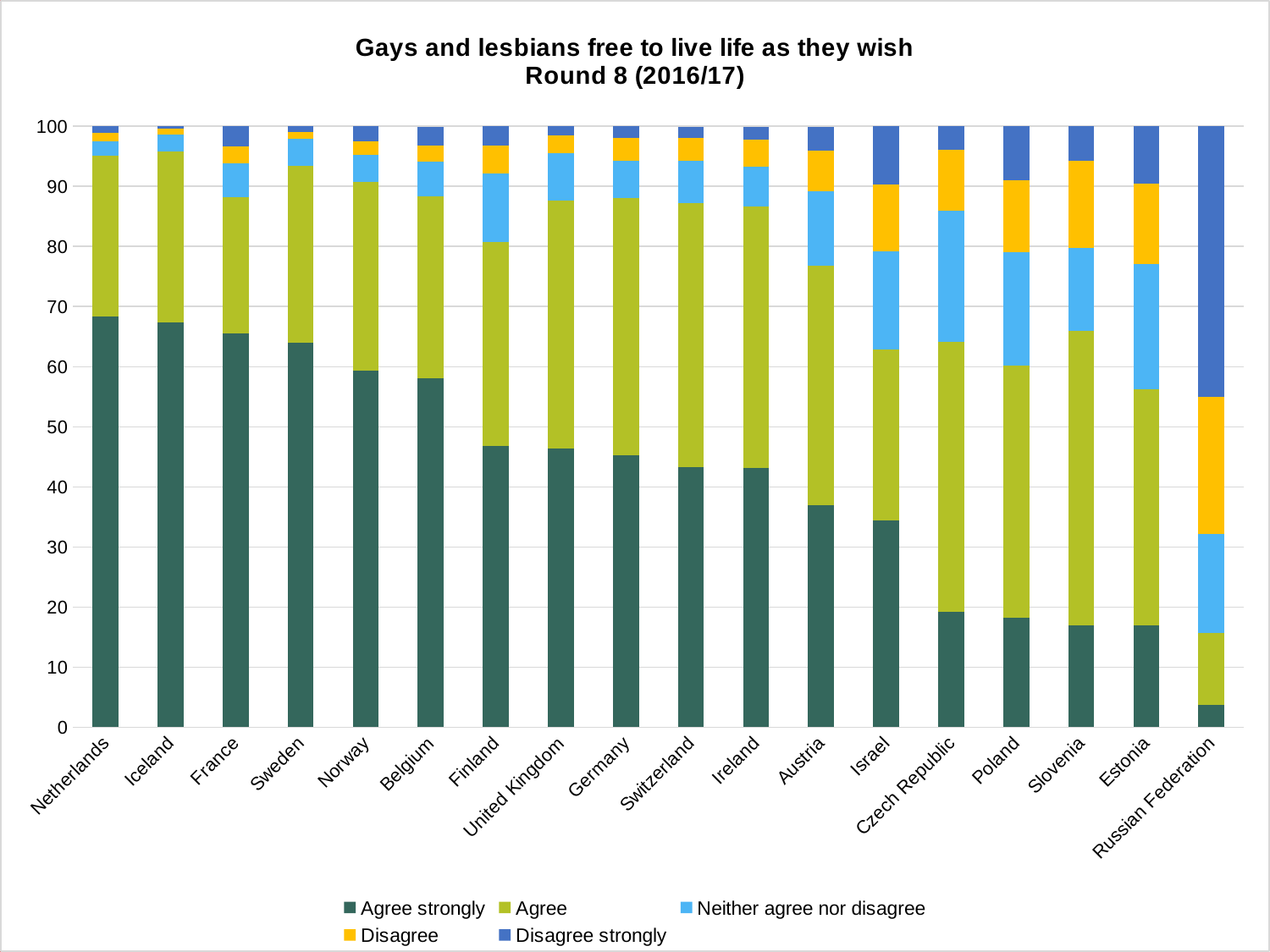
Do the 'Agree strongly' values rise or fall moving from left to right along the x axis? fall What is the title of the chart? Gays and lesbians free to live life as they wish Round 8 (2016/17) What is the total of the stacked bar for the Netherlands? 100 Is the 'Agree strongly' value for the Russian Federation greater or less than 10? less How many series does the legend list? 5 Is the 'Agree strongly' value for the Netherlands greater or less than 60? greater Which country has the smallest 'Agree strongly' segment? Russian Federation Which has a larger 'Agree strongly' value, Norway or Finland? Norway Which country has the largest 'Disagree strongly' segment? Russian Federation How many countries are shown along the x axis? 18 Is the 'Agree strongly' value for Israel greater or less than 40? less What kind of chart is shown on the slide? bar chart